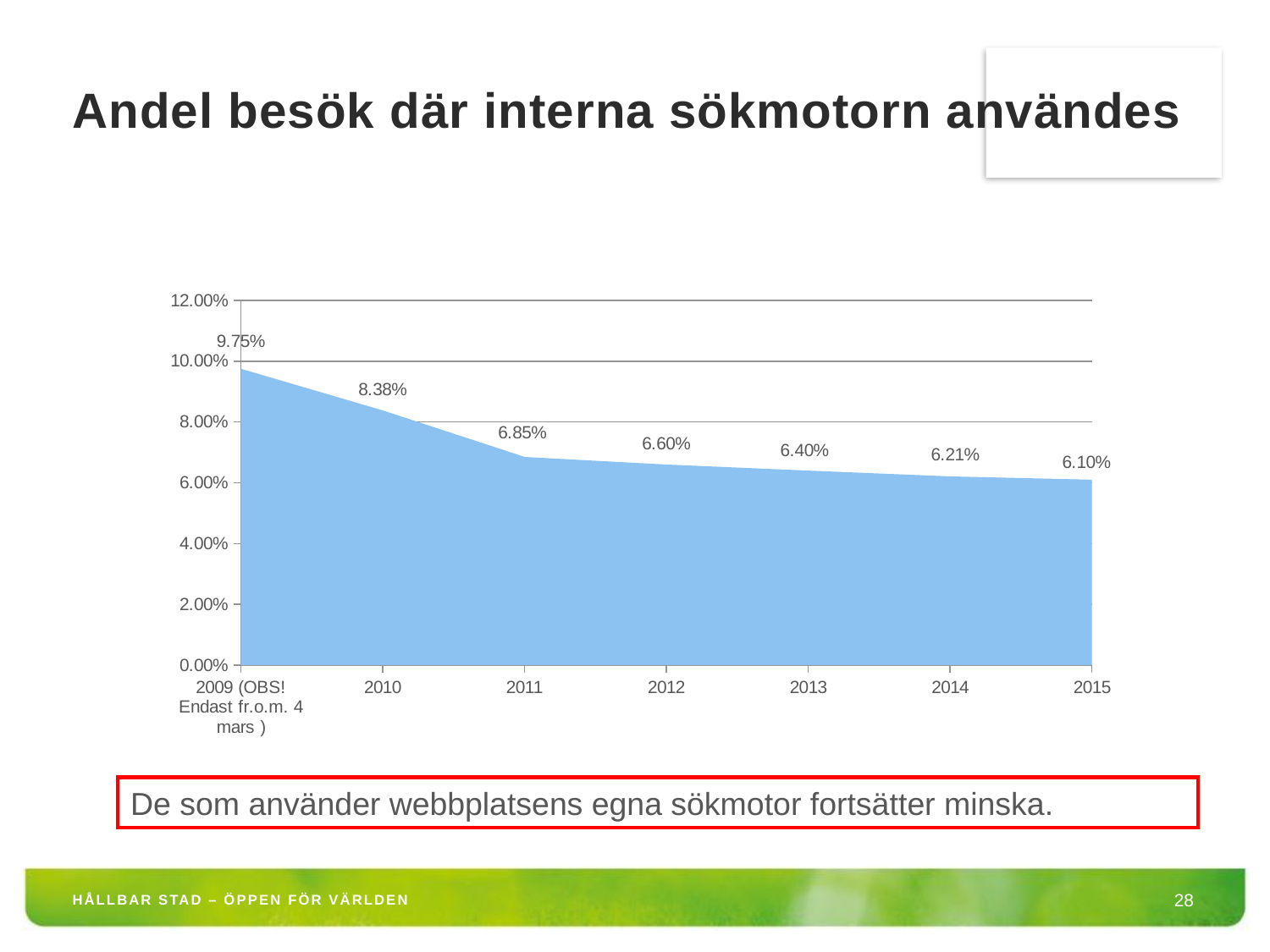
What is the value for 2013? 6.40% What is the value for 2015? 6.10% What is the difference between the values for 2009 and 2015? 3.65% What kind of chart is shown? area chart Which is larger, the value for 2012 or the value for 2014? 2012 Do the values rise or fall from 2009 to 2015? fall Which year has the highest value? 2009 What is the difference between the values for 2010 and 2011? 1.53% Which year has the lowest value? 2015 Is the value for 2011 greater or less than 8.00%? less What is the value for 2010? 8.38% How many years are plotted on the chart? 7